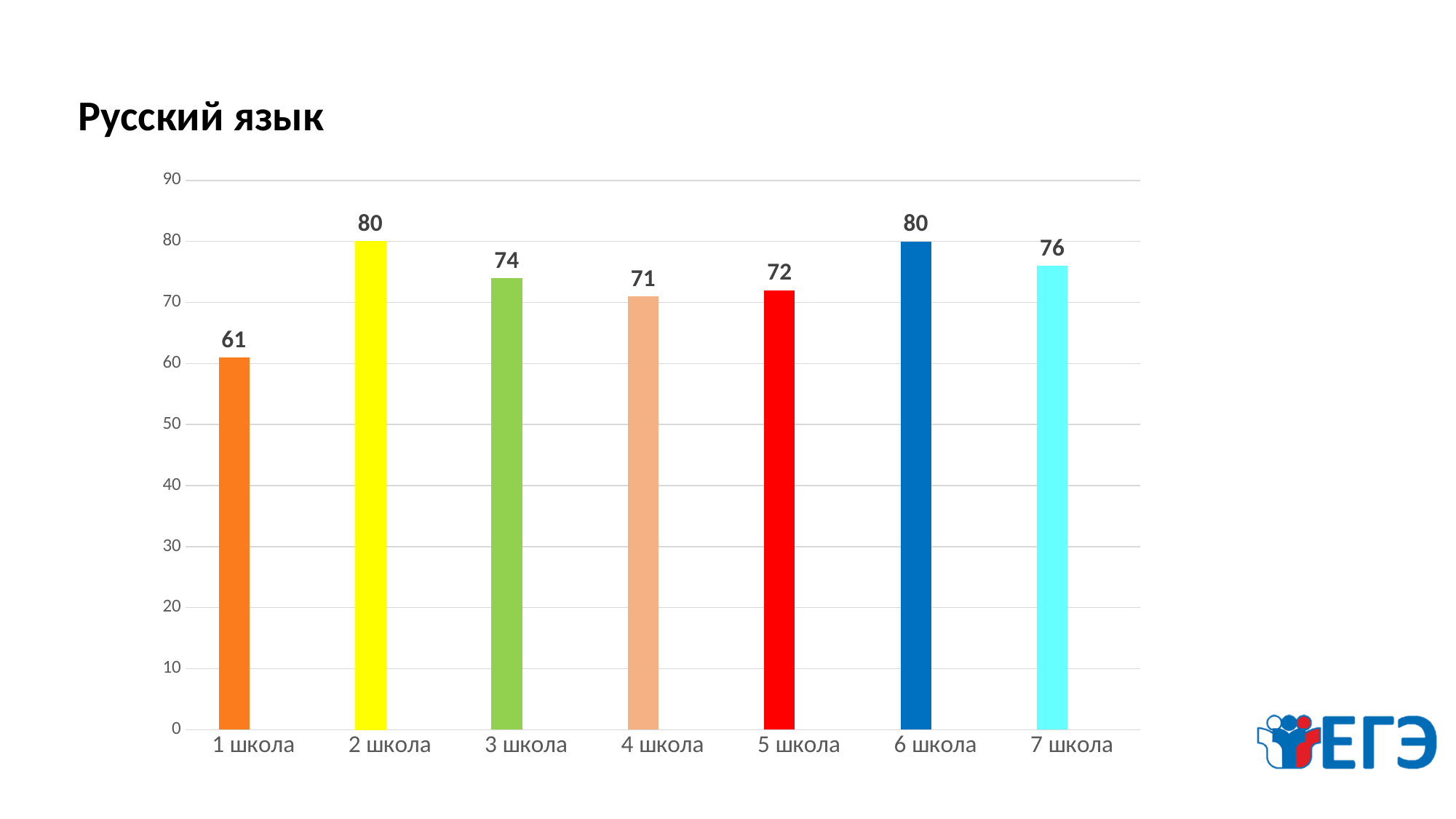
Which is larger, the value for 4 школа or the value for 3 школа? 3 школа What is the difference between the values for 7 школа and 5 школа? 4 What is the value for 3 школа? 74 What is the title of the slide? Русский язык How many categories are shown on the x axis? 7 Is the value for 5 школа greater or less than 70? greater Which categories share the highest value? 2 школа and 6 школа What is the difference between the values for 2 школа and 1 школа? 19 Which category has the lowest value? 1 школа What kind of chart is shown on the slide? bar chart What is the value for 1 школа? 61 What is the value for 7 школа? 76